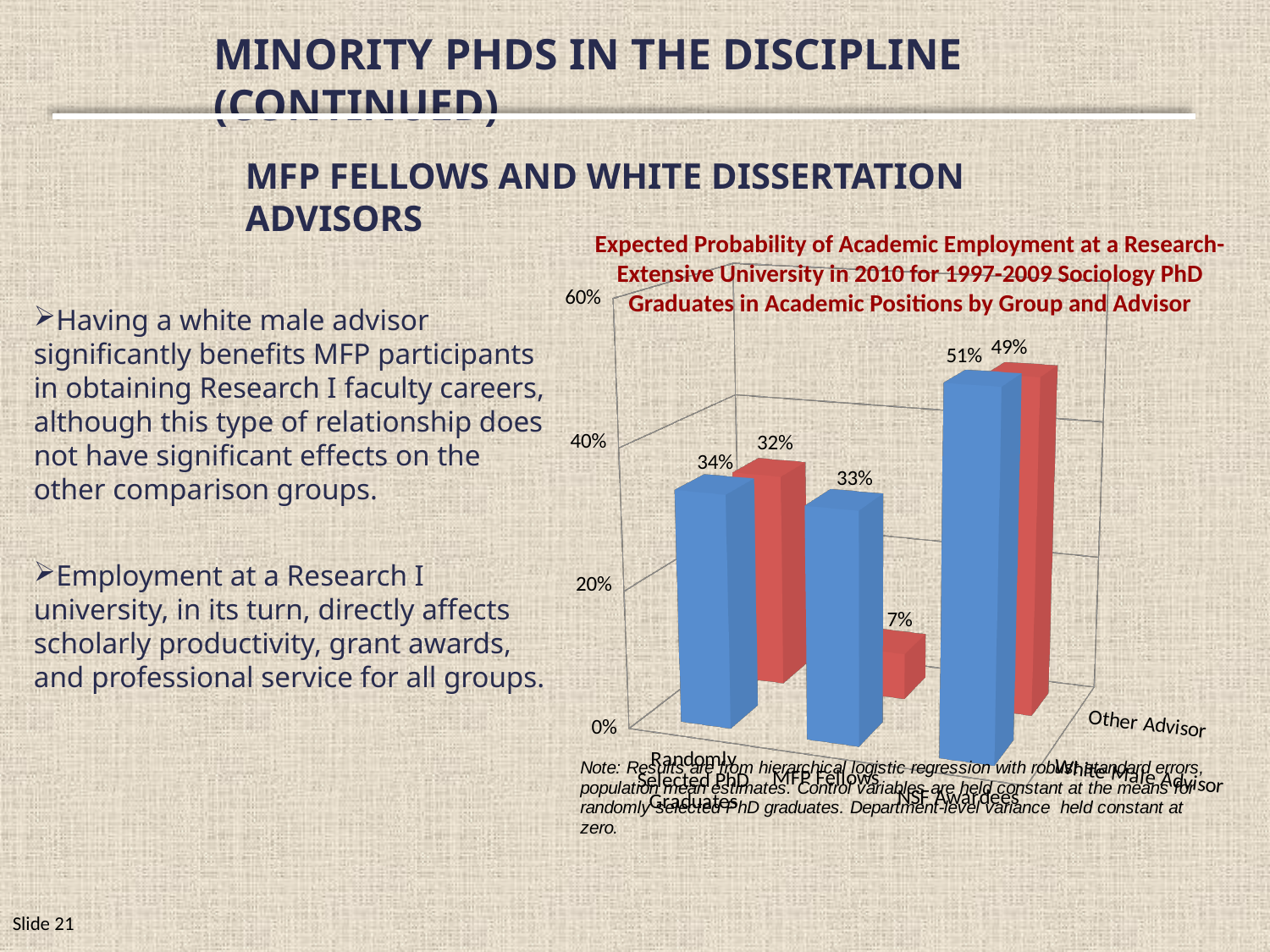
Is the value for NSF Awardees with a White Male Advisor greater or less than 40%? greater What is the expected probability for MFP Fellows with a White Male Advisor? 33% What is the difference between the White Male Advisor and Other Advisor values for MFP Fellows? 26 percentage points Which group has the lowest expected probability with an Other Advisor? MFP Fellows What kind of chart is shown on the slide? Bar chart Which group has the highest expected probability with a White Male Advisor? NSF Awardees Which is larger for NSF Awardees: the White Male Advisor value or the Other Advisor value? White Male Advisor What is the expected probability for NSF Awardees with a White Male Advisor? 51% How many groups are shown on the x axis of the chart? 3 How many advisor series does the chart show? 2 What is the expected probability for MFP Fellows with an Other Advisor? 7% What is the expected probability for Randomly Selected PhD Graduates with an Other Advisor? 32%